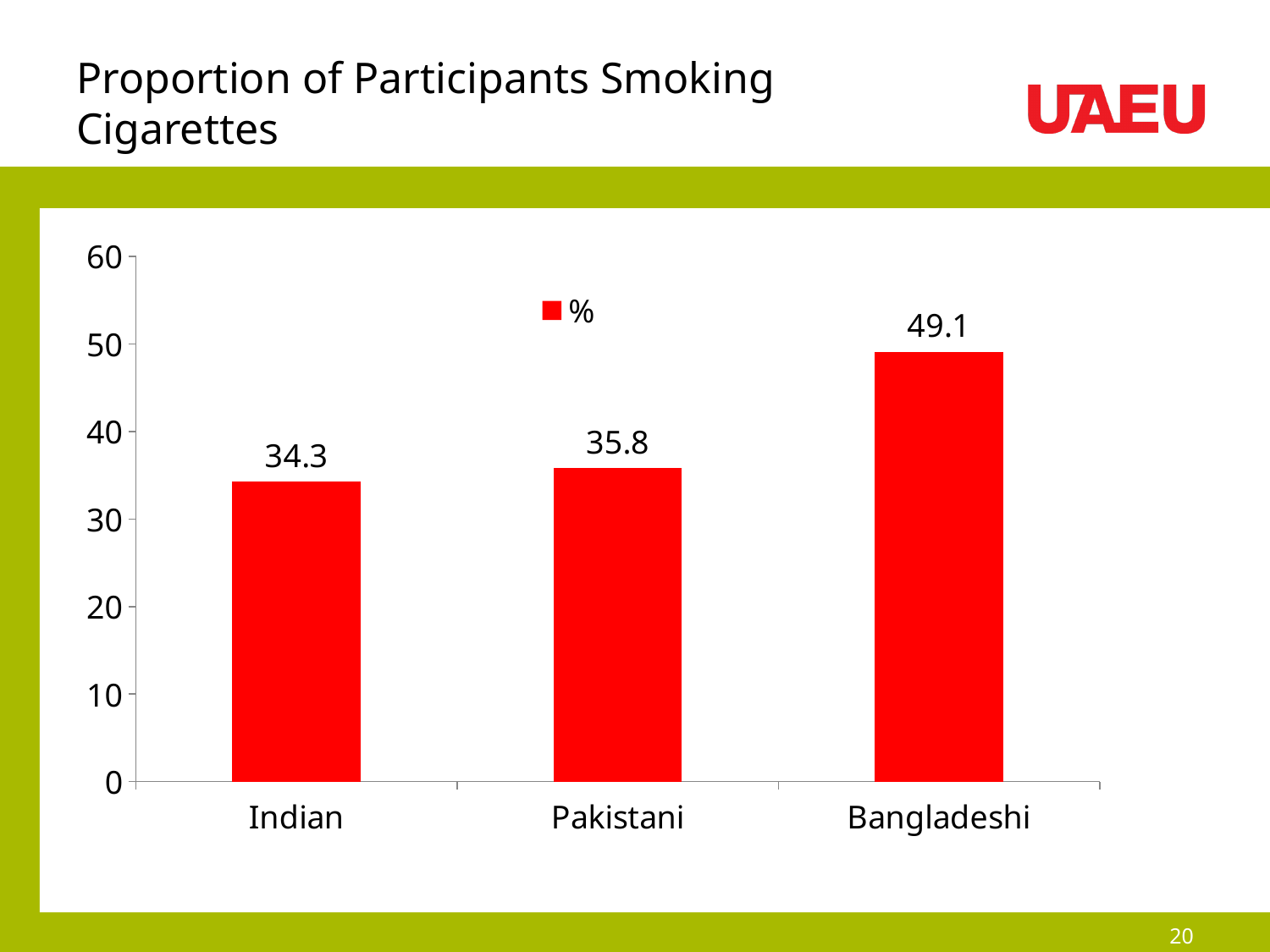
What is the legend entry shown on the chart? % What is the value for Indian? 34.3 What is the difference between the values for Pakistani and Indian? 1.5 What is the value for Bangladeshi? 49.1 Which is larger, the value for Bangladeshi or the value for Pakistani? Bangladeshi What kind of chart is shown on the slide? bar chart Is the value for Bangladeshi greater or less than 40? greater What is the value for Pakistani? 35.8 What is the difference between the values for Bangladeshi and Indian? 14.8 Which category has the highest value? Bangladeshi Which category has the lowest value? Indian How many categories are shown on the x axis? 3